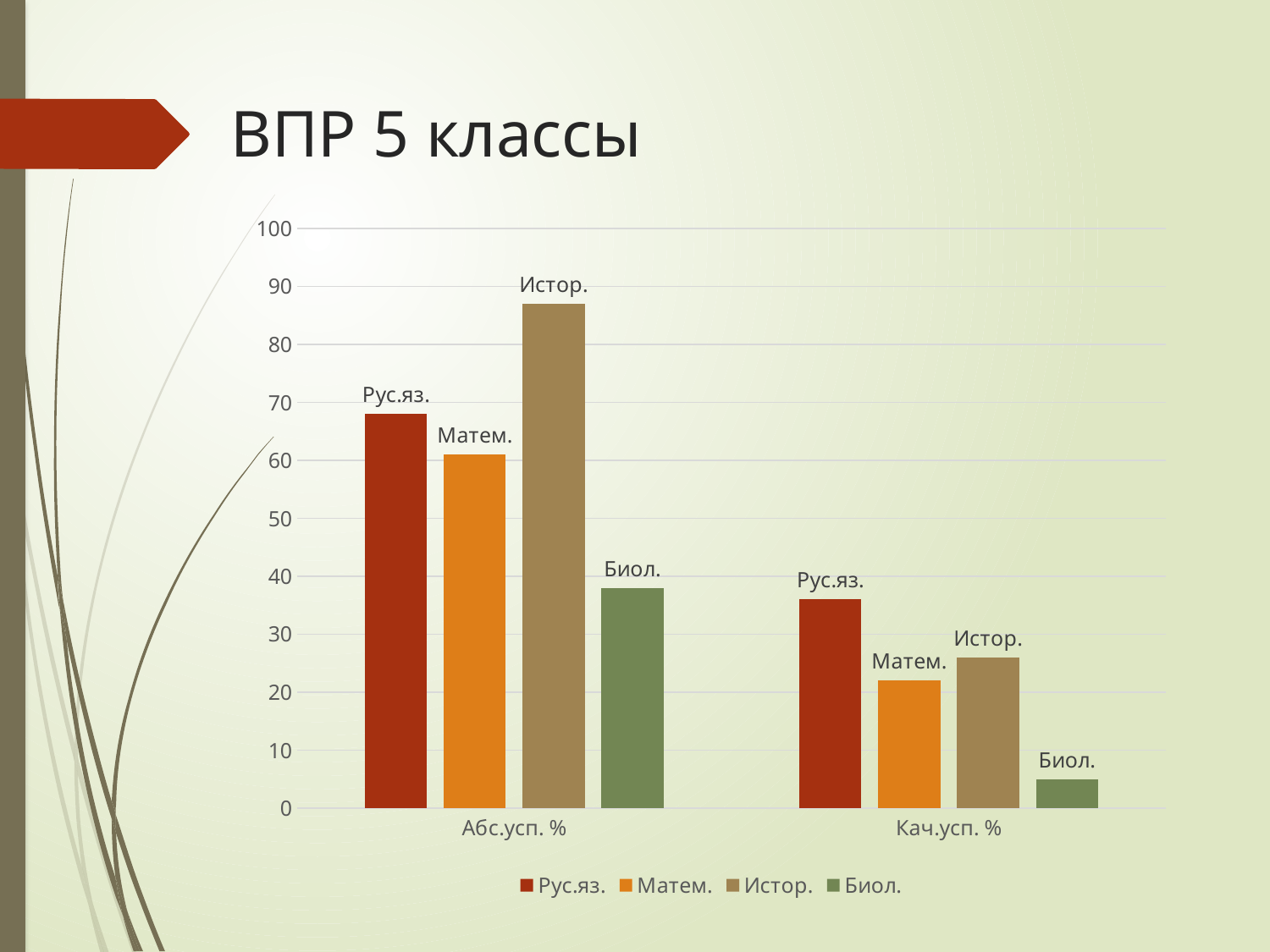
Which subject has the lowest bar in the Абс.усп. % category? Биол. In the Абс.усп. % category, which is larger: the value for Рус.яз. or the value for Матем.? Рус.яз. How many series does the legend list? 4 Is the value for Матем. in the Абс.усп. % category greater or less than 50? greater Which subject has the highest bar in the Кач.усп. % category? Рус.яз. Is the value for Биол. in the Кач.усп. % category greater or less than 10? less What kind of chart is shown on the slide? bar chart Is the value for Истор. in the Абс.усп. % category greater or less than 80? greater How many categories are shown on the x axis? 2 Which subject has the lowest bar in the Кач.усп. % category? Биол. What is the title of the slide containing the chart? ВПР 5 классы Which subject has the highest bar in the Абс.усп. % category? Истор.